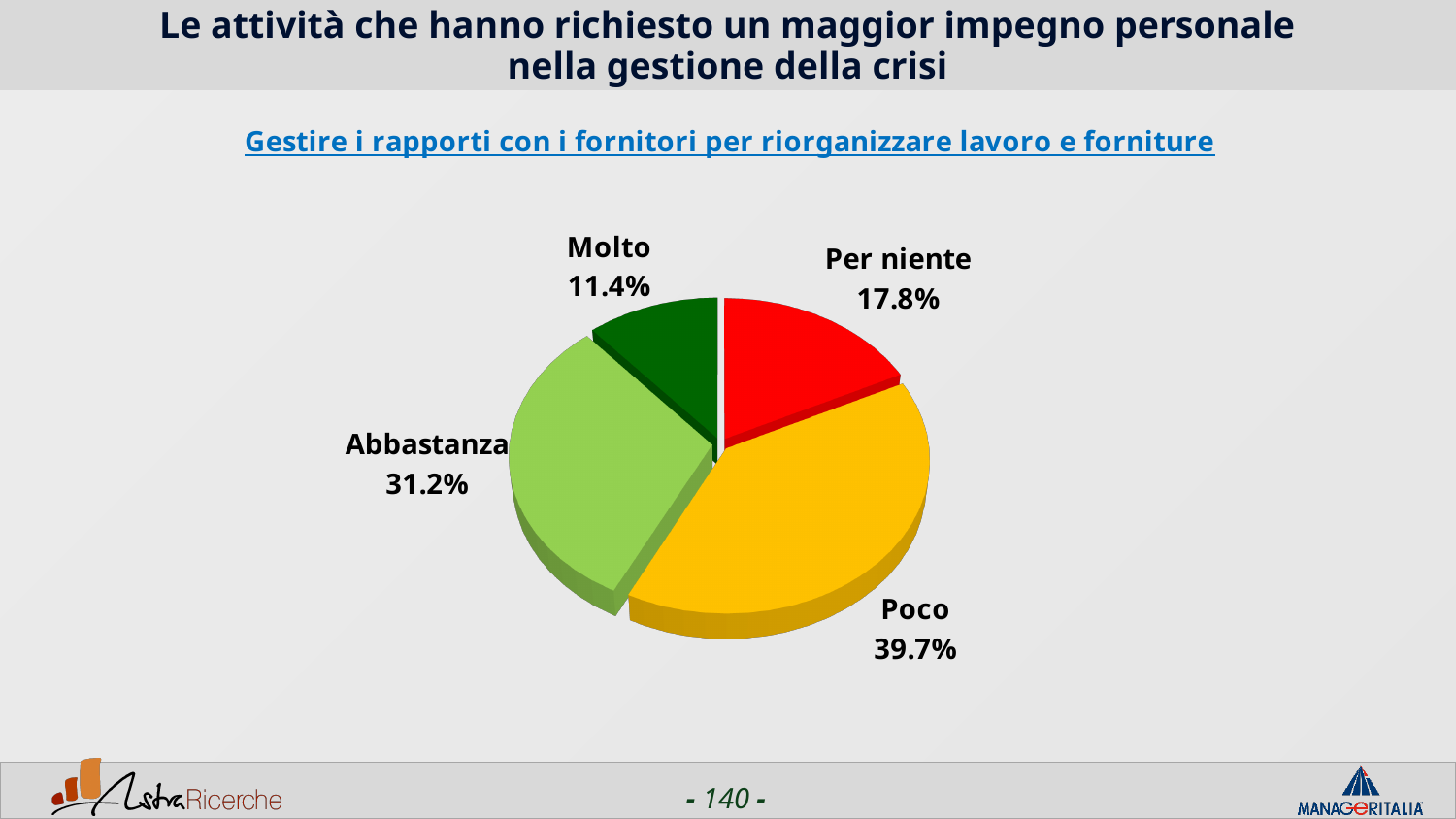
What is the combined share of the "Molto" and "Abbastanza" slices? 42.6% What kind of chart is shown on the slide? Pie chart How many slices does the pie chart have? 4 Which slice is larger, "Per niente" or "Molto"? Per niente What is the difference in percentage points between the "Poco" and "Abbastanza" slices? 8.5 What percentage of the pie chart is labelled "Per niente"? 17.8% Which category has the smallest slice of the pie chart? Molto Which category has the largest slice of the pie chart? Poco What percentage of the pie chart is labelled "Molto"? 11.4% What percentage of the pie chart is labelled "Abbastanza"? 31.2% What colour is the "Per niente" slice of the pie chart? Red What percentage of the pie chart is labelled "Poco"? 39.7%